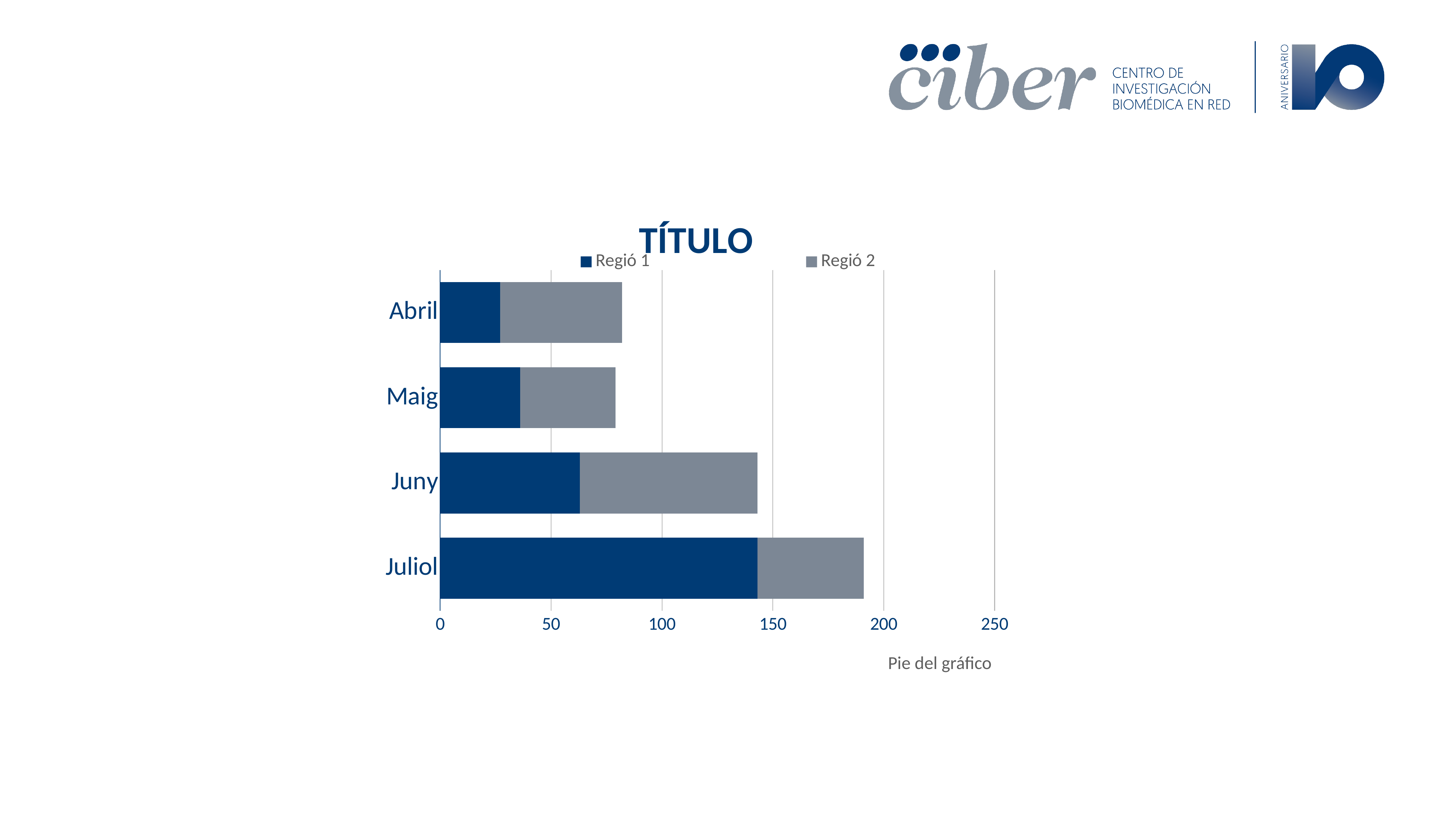
Is the Regió 1 value for Juliol greater or less than 100? greater Is the total stacked bar for Juny greater or less than 100? greater Is the Regió 1 value for Maig greater or less than 50? less Which has the larger total stacked bar, Juny or Abril? Juny What is the title of the chart? TÍTULO Which month has the longest total stacked bar? Juliol What kind of chart is shown on the slide? bar chart Which month has the larger Regió 1 value, Juliol or Juny? Juliol How many series does the legend list? 2 How many categories (months) are shown on the chart? 4 What are the two series named in the legend? Regió 1 and Regió 2